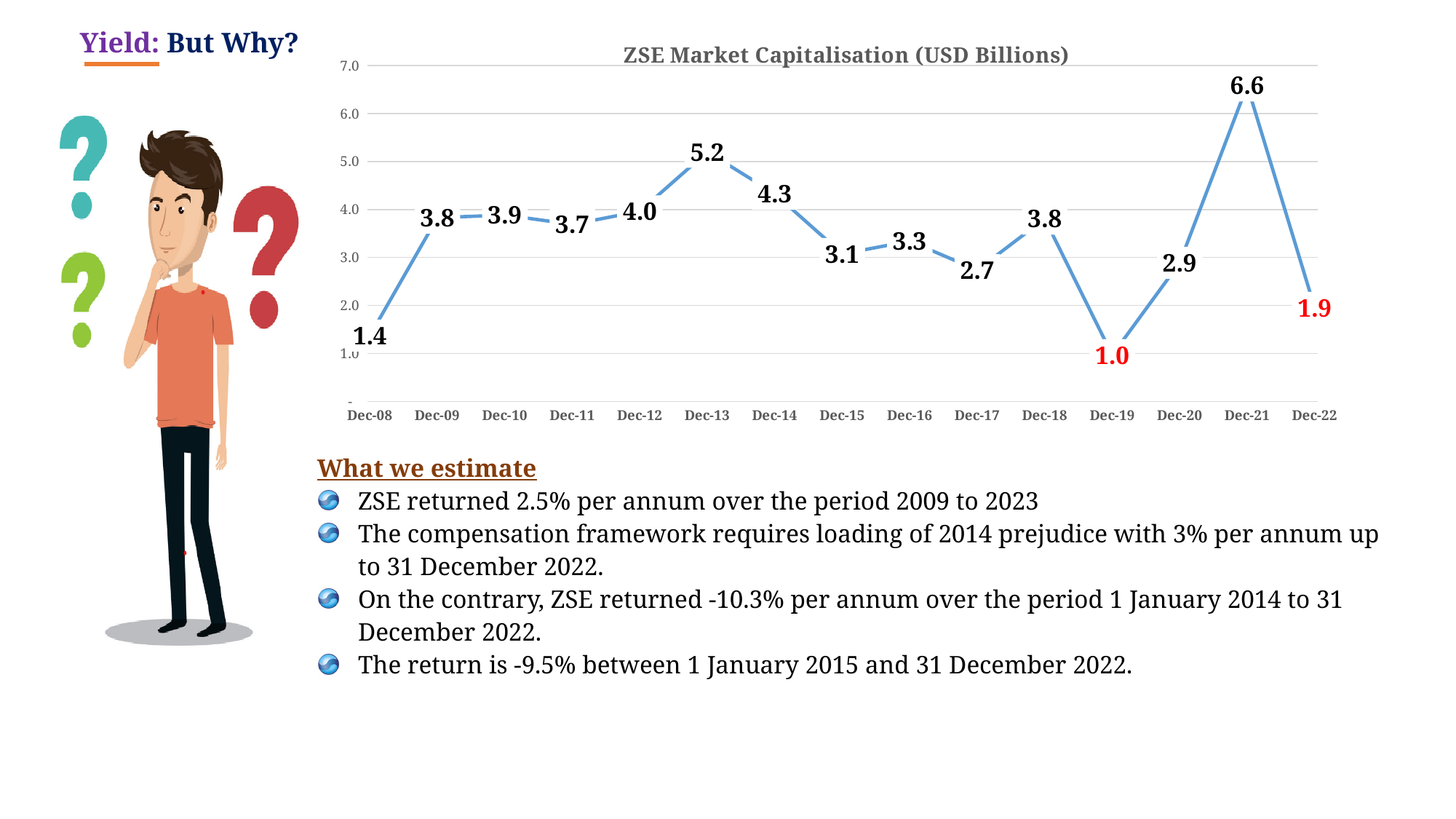
Which date has the lowest ZSE market capitalisation? Dec-19 Does the market capitalisation rise or fall from Dec-13 to Dec-17? fall What is the ZSE market capitalisation for Dec-22? 1.9 What kind of chart is shown on the slide? line chart Which is larger, the market capitalisation in Dec-14 or Dec-18? Dec-14 What is the ZSE market capitalisation for Dec-19? 1.0 What is the title of the chart? ZSE Market Capitalisation (USD Billions) What is the difference between the market capitalisation in Dec-21 and Dec-22? 4.7 What is the ZSE market capitalisation for Dec-13? 5.2 Is the value for Dec-21 greater or less than 6.0? greater How many data points are plotted on the chart? 15 Which date has the highest ZSE market capitalisation? Dec-21